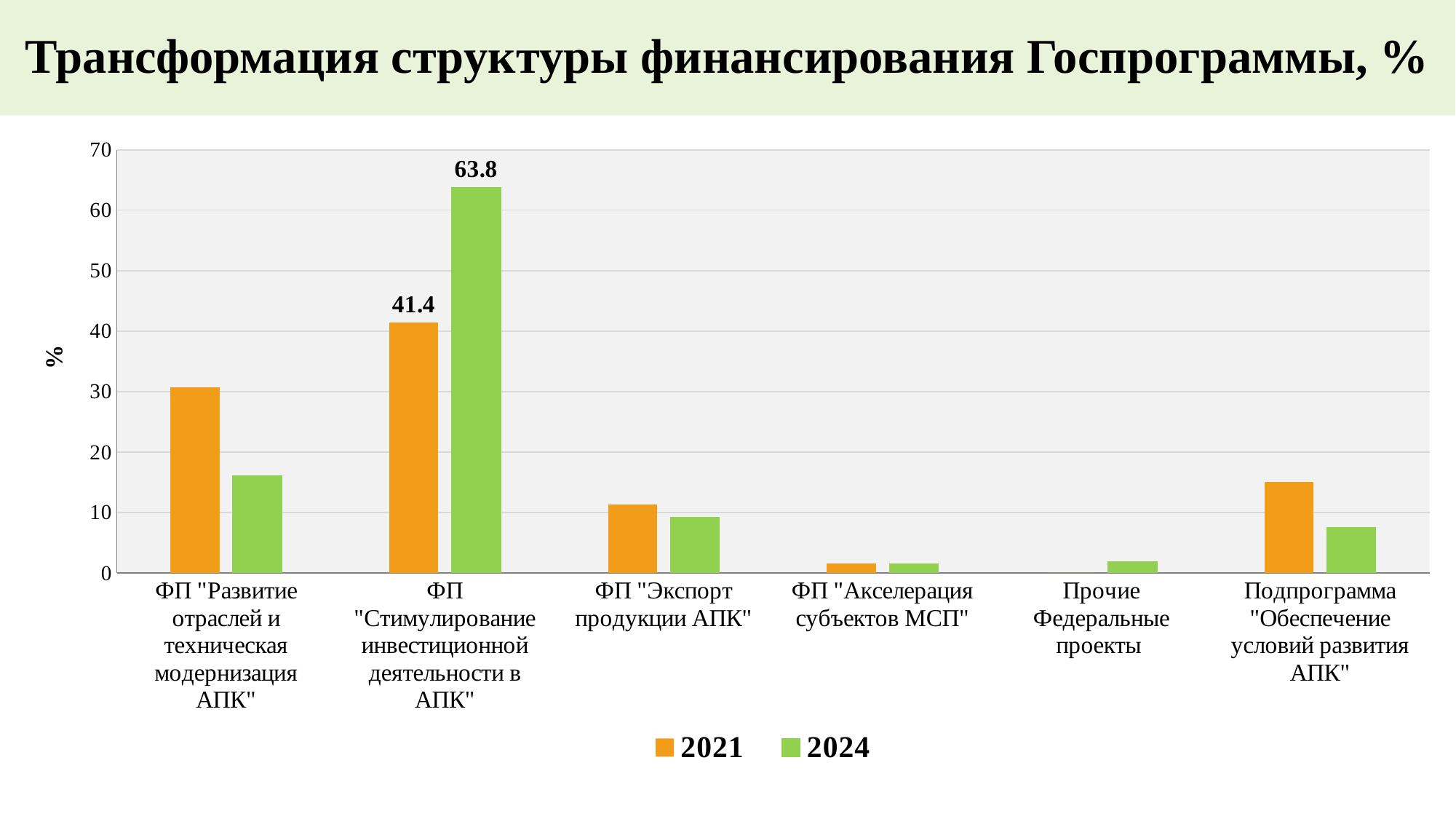
How many series does the legend list? 2 Is the 2024 value for Подпрограмма "Обеспечение условий развития АПК" greater or less than 10? less For Подпрограмма "Обеспечение условий развития АПК", which is larger: the 2021 value or the 2024 value? 2021 Which category has the highest 2024 value? ФП "Стимулирование инвестиционной деятельности в АПК" What is the value for 2024 for ФП "Стимулирование инвестиционной деятельности в АПК"? 63.8 For ФП "Развитие отраслей и техническая модернизация АПК", which is larger: the 2021 value or the 2024 value? 2021 What is the value for 2021 for ФП "Стимулирование инвестиционной деятельности в АПК"? 41.4 What kind of chart is shown on the slide? bar chart Which category has the highest 2021 value? ФП "Стимулирование инвестиционной деятельности в АПК" How many categories are shown on the x axis? 6 What is the difference between the 2024 and 2021 values for ФП "Стимулирование инвестиционной деятельности в АПК"? 22.4 Is the 2021 value for ФП "Развитие отраслей и техническая модернизация АПК" greater or less than 20? greater